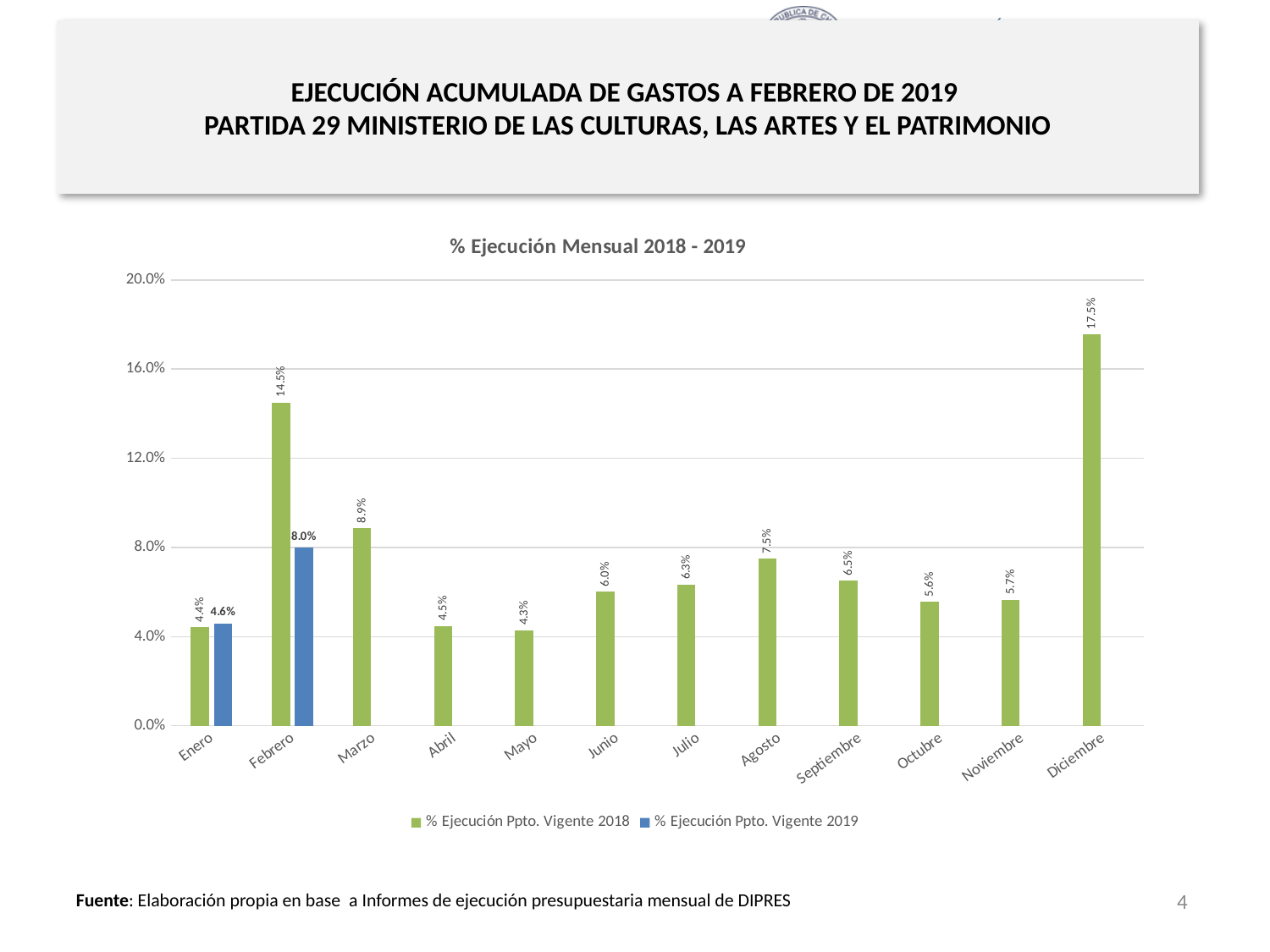
What is the value for Febrero in the % Ejecución Ppto. Vigente 2019 series? 8.0% What kind of chart is shown on the slide? Bar chart Which month has the lowest value in the % Ejecución Ppto. Vigente 2018 series? Mayo What is the difference between the Febrero values for 2018 and 2019? 6.5% How many months are shown on the x axis? 12 How many series does the legend list? 2 Which month has the highest value in the % Ejecución Ppto. Vigente 2018 series? Diciembre Is the value for Marzo in the 2018 series greater or less than 8.0%? greater Which is larger for Enero: the 2018 value or the 2019 value? 2019 (4.6%) What is the value for Enero in the % Ejecución Ppto. Vigente 2019 series? 4.6% What is the title of the chart? % Ejecución Mensual 2018 - 2019 What is the value for Febrero in the % Ejecución Ppto. Vigente 2018 series? 14.5%